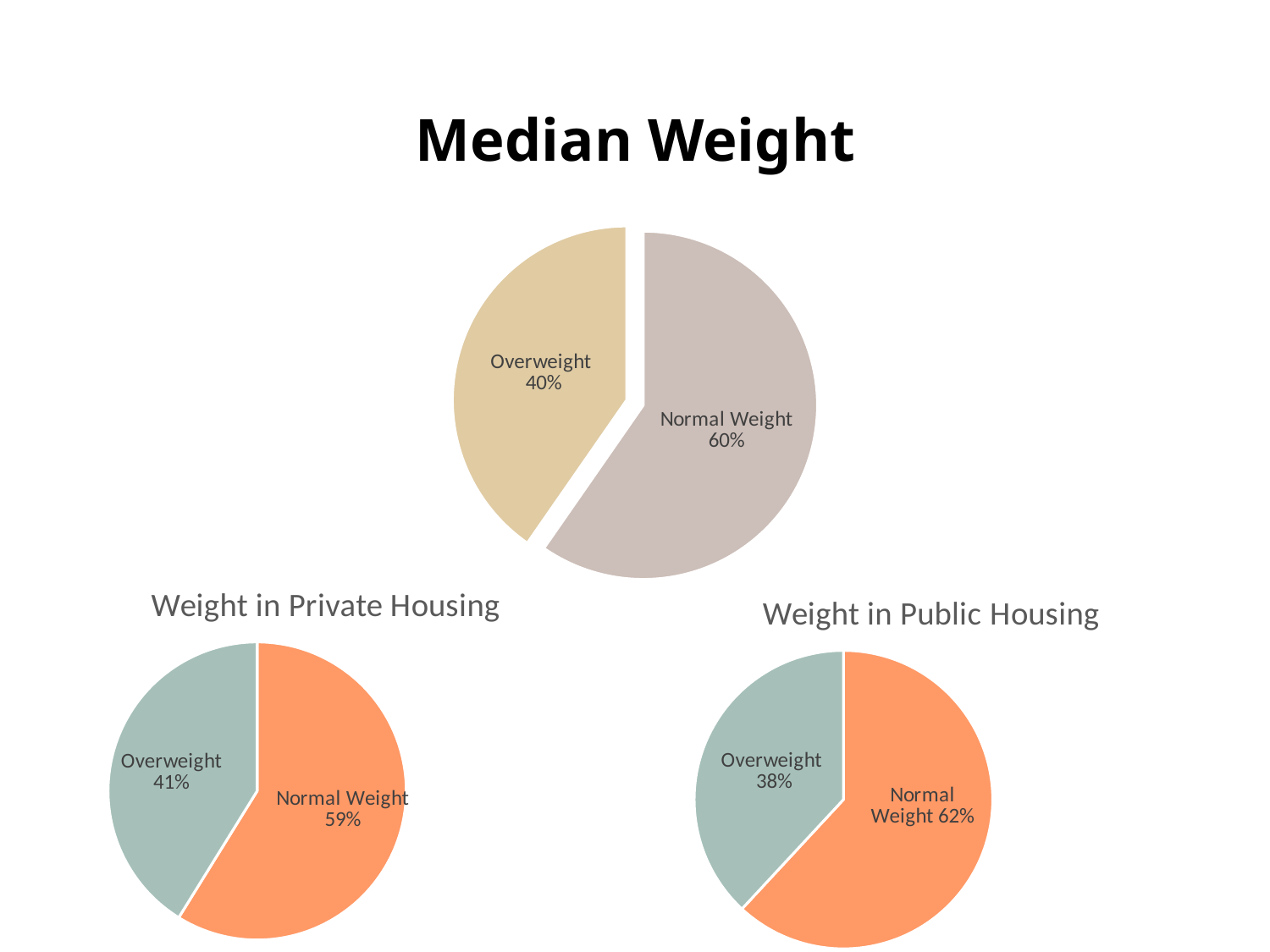
In the 'Weight in Public Housing' chart, what is the value for Normal Weight? 62% In the 'Weight in Private Housing' chart, what is the value for Normal Weight? 59% In the 'Weight in Public Housing' chart, what is the difference between the Normal Weight and Overweight shares? 24% In the 'Weight in Public Housing' chart, which slice is the largest? Normal Weight In the 'Weight in Private Housing' chart, what is the value for Overweight? 41% What type of chart is the 'Weight in Private Housing' chart? Pie chart How many slices does the top pie chart under the 'Median Weight' heading have? 2 In the top pie chart under the 'Median Weight' heading, what share is labelled Normal Weight? 60% In the 'Weight in Public Housing' chart, what is the value for Overweight? 38% In the top pie chart under the 'Median Weight' heading, what share is labelled Overweight? 40% Which is larger: the Overweight share in the 'Weight in Private Housing' chart or the Overweight share in the 'Weight in Public Housing' chart? Weight in Private Housing In the 'Weight in Private Housing' chart, which slice is the smallest? Overweight